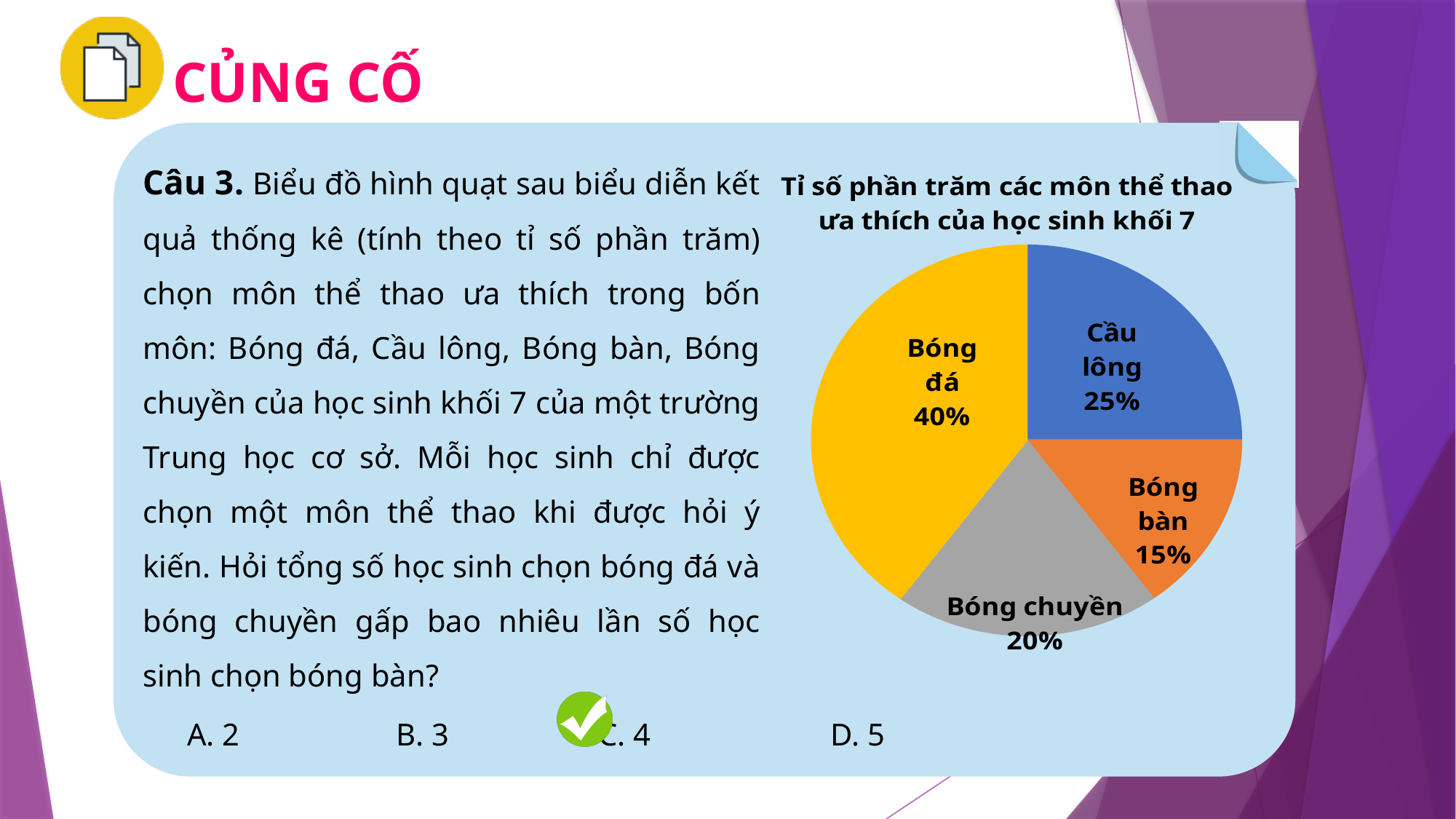
What percentage of the pie chart is Cầu lông? 25% What percentage of the pie chart is Bóng chuyền? 20% What is the difference in percentage points between Bóng đá and Cầu lông? 15% What is the title of the pie chart? Tỉ số phần trăm các môn thể thao ưa thích của học sinh khối 7 Which is larger, the slice for Bóng chuyền or the slice for Bóng bàn? Bóng chuyền Which sport has the largest slice in the pie chart? Bóng đá What percentage of the pie chart is Bóng đá? 40% How many slices does the pie chart have? 4 What percentage of the pie chart is Bóng bàn? 15% What type of chart is shown on the slide? pie chart What colour is the Bóng đá slice in the pie chart? yellow Which sport has the smallest slice in the pie chart? Bóng bàn